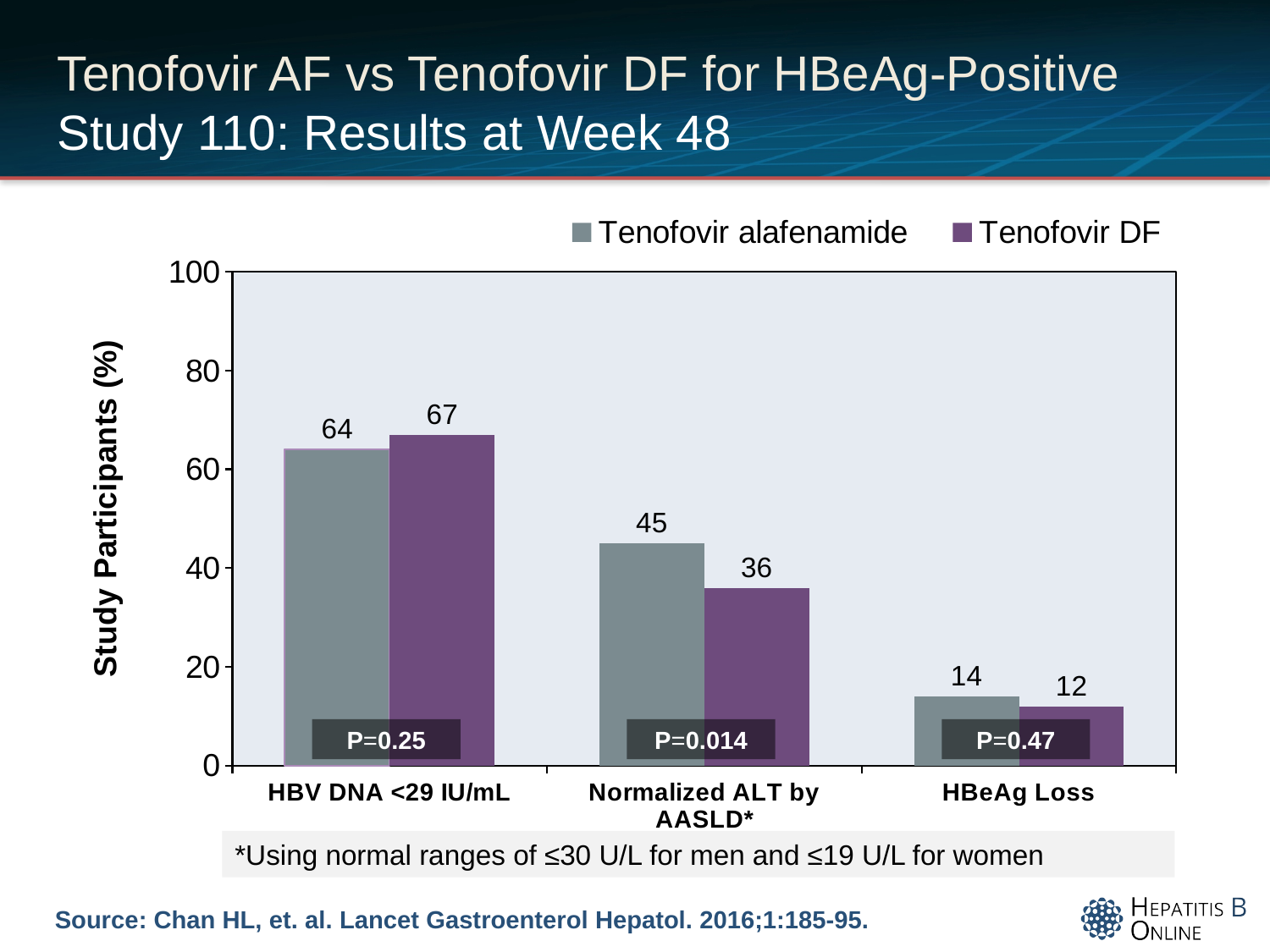
What is the y-axis label of the chart? Study Participants (%) What is the value for Tenofovir DF in the HBeAg Loss category? 12 What is the value for Tenofovir DF in the Normalized ALT by AASLD* category? 36 Which category has the lowest value for Tenofovir alafenamide? HBeAg Loss How many categories are shown on the x axis? 3 Is the value for Tenofovir alafenamide in the HBeAg Loss category greater or less than 20? less What is the value for Tenofovir alafenamide in the HBV DNA <29 IU/mL category? 64 What kind of chart is shown on the slide? bar chart Which category has the highest value for Tenofovir DF? HBV DNA <29 IU/mL How many series does the legend list? 2 In the HBV DNA <29 IU/mL category, which series has the larger value? Tenofovir DF What is the difference between the Tenofovir alafenamide and Tenofovir DF values in the Normalized ALT by AASLD* category? 9